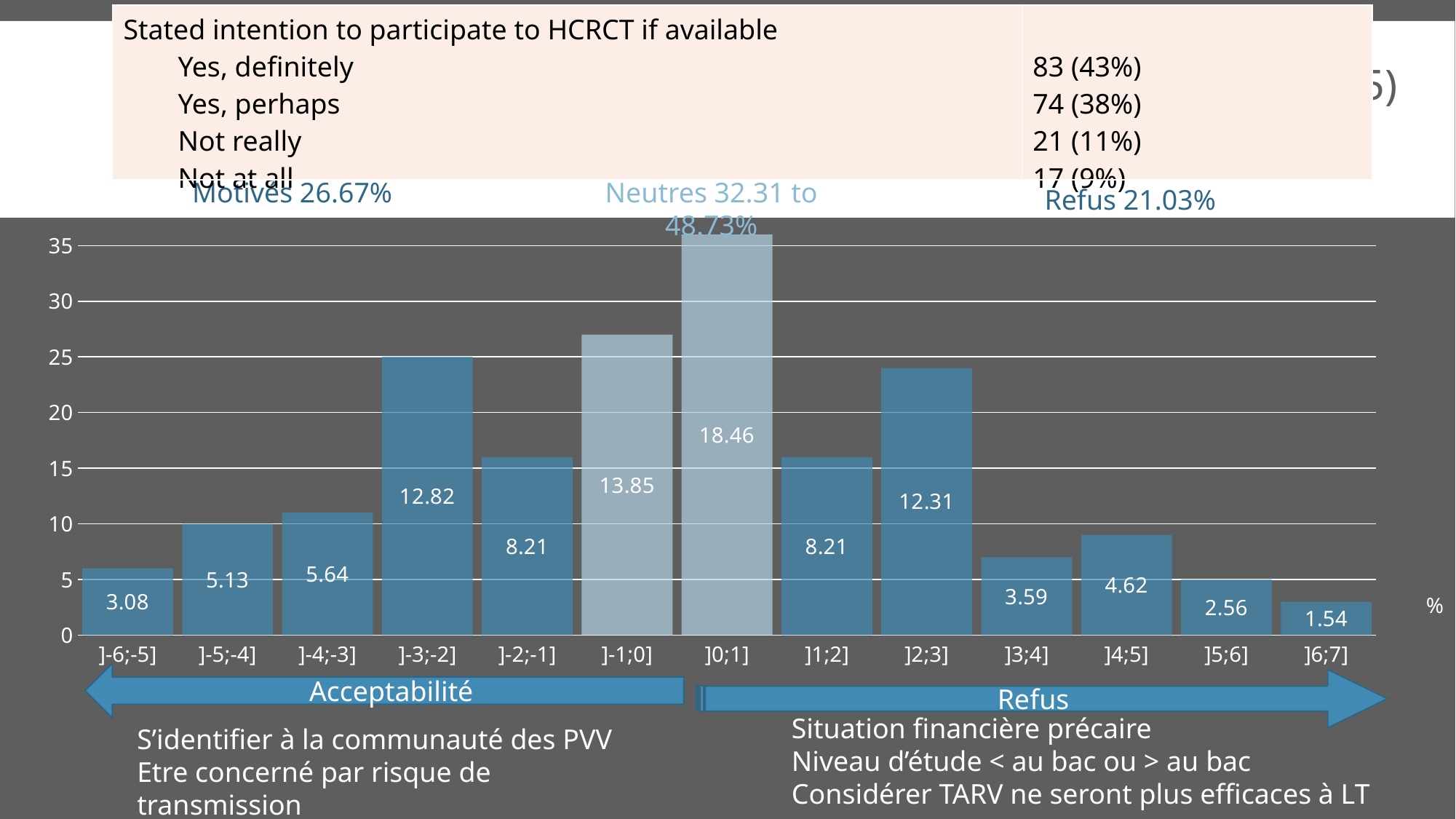
Which is larger, the value for ]-3;-2] or the value for ]2;3]? ]-3;-2] What percentage is shown next to the label 'Refus' above the chart? 21.03% What is the value shown for the ]-1;0] category? 13.85 What is the value shown for the ]-3;-2] category? 12.82 Which category has the highest value? ]0;1] What is the value shown for the ]0;1] category? 18.46 Which category has the lowest value? ]6;7] How many categories are shown on the x axis? 13 What is the difference between the values for ]0;1] and ]-1;0]? 4.61 What kind of chart is shown on the slide? bar chart What is the value shown for the ]6;7] category? 1.54